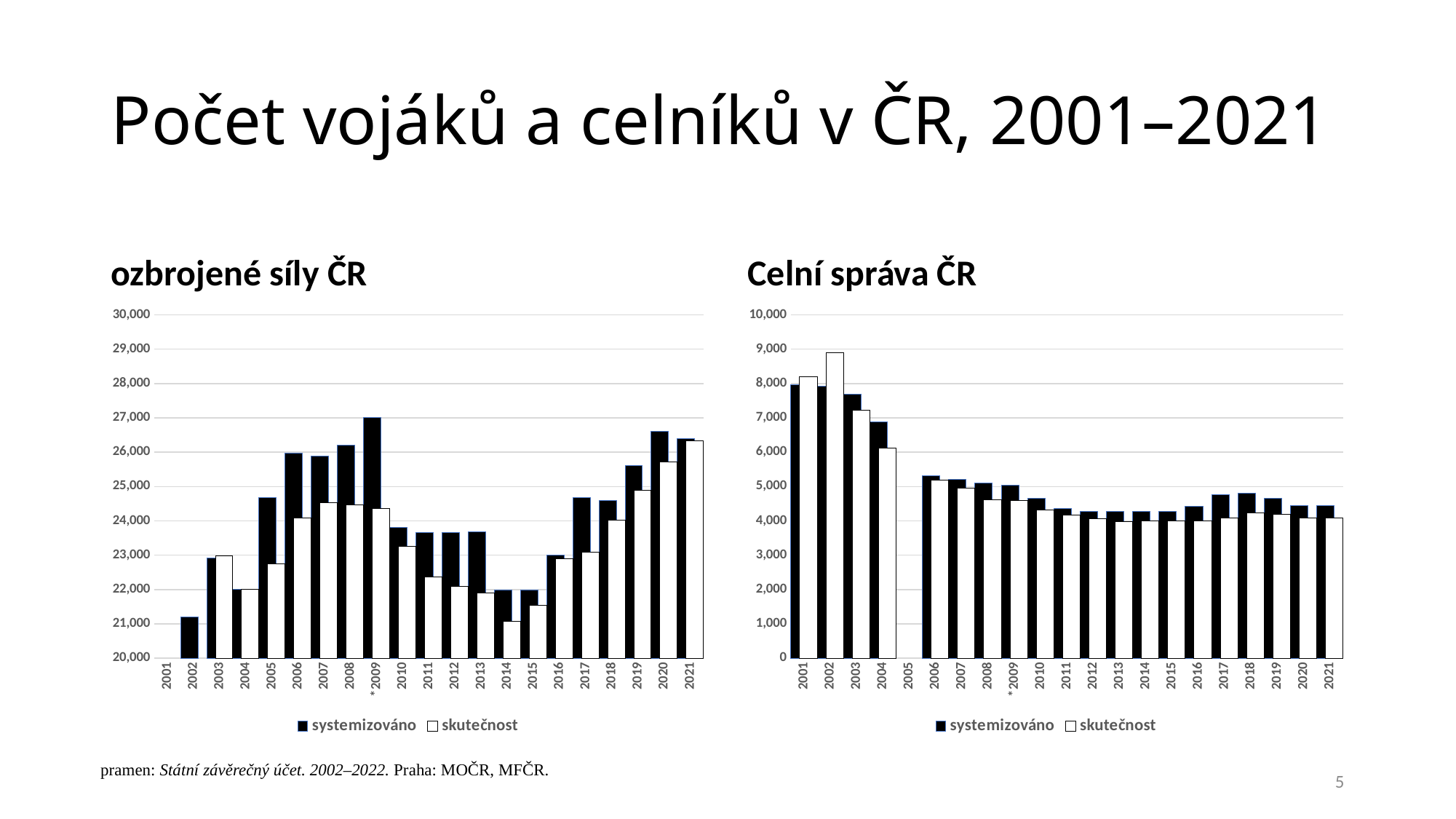
In the 'ozbrojené síly ČR' chart, is the systemizováno value for 2009 greater or less than 26,000? greater In the 'Celní správa ČR' chart, do the systemizováno values rise or fall from 2001 to 2004? fall What kind of chart is the 'ozbrojené síly ČR' chart? bar chart In the 'Celní správa ČR' chart, which is larger: the systemizováno value for 2001 or for 2021? 2001 In the 'ozbrojené síly ČR' chart, which year has the highest systemizováno value? 2009 In the 'Celní správa ČR' chart, is the skutečnost value for 2004 greater or less than 7,000? less Which series is shown with black bars in the 'ozbrojené síly ČR' chart? systemizováno In the 'ozbrojené síly ČR' chart, is the skutečnost value for 2014 greater or less than 22,000? less How many series does the legend of the 'Celní správa ČR' chart list? 2 In the 'ozbrojené síly ČR' chart, which is larger for 2009: systemizováno or skutečnost? systemizováno In the 'Celní správa ČR' chart, which year has the highest skutečnost value? 2002